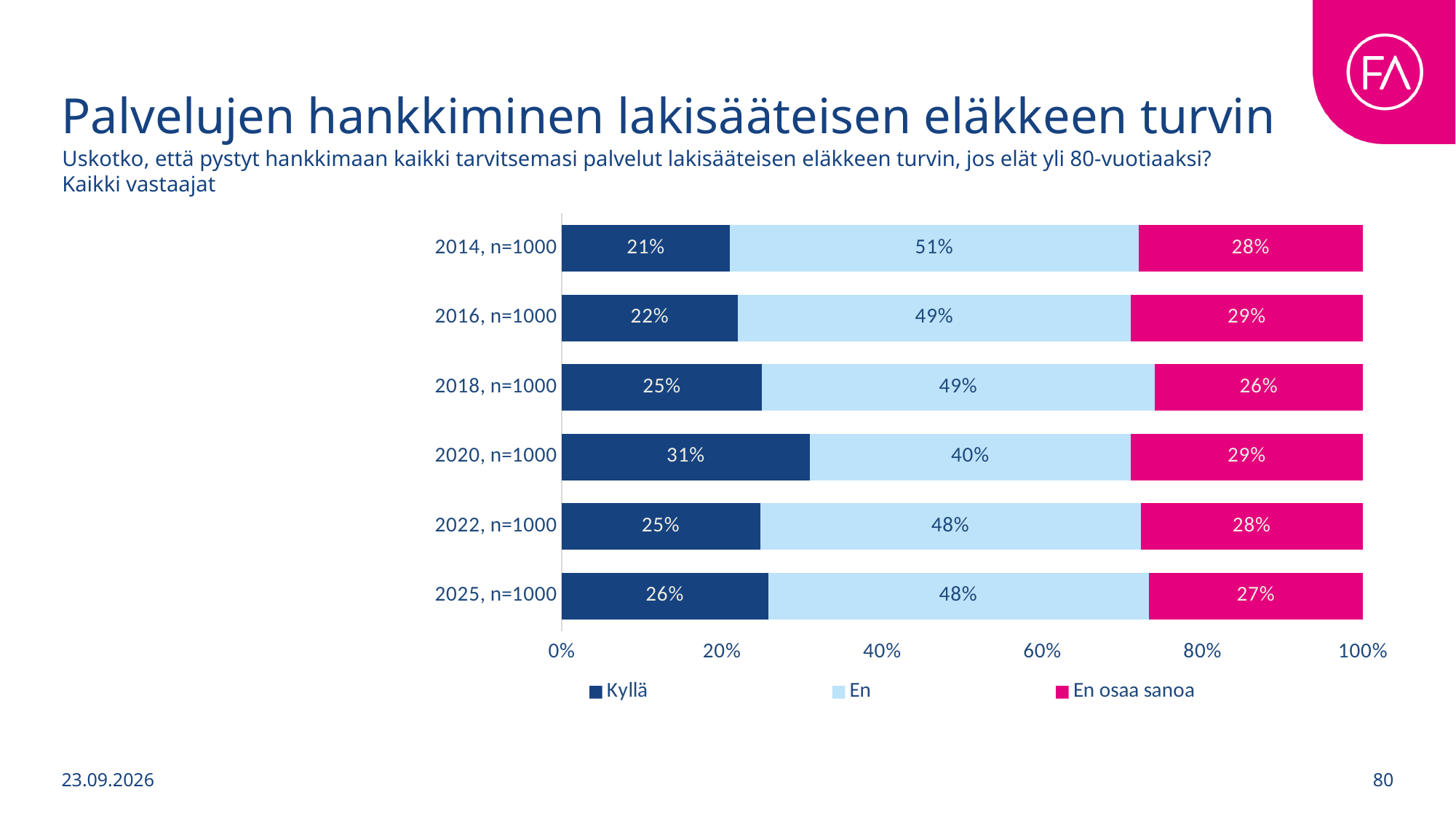
In which year was the "Kyllä" share the lowest? 2014, n=1000 What percentage of respondents answered "En osaa sanoa" in 2025, n=1000? 27% How many series does the legend list? 3 What kind of chart is shown on the slide? Stacked bar chart In which year was the "En" share the lowest? 2020, n=1000 What is the difference between the "Kyllä" share in 2020 and in 2014? 10 percentage points What percentage of respondents answered "En" in 2014, n=1000? 51% How many years (categories) are shown in the chart? 6 Which is larger: the "En" share in 2014 or the "En" share in 2022? 2014 What percentage of respondents answered "Kyllä" in 2020, n=1000? 31% In which year was the "Kyllä" share the highest? 2020, n=1000 Which series is shown in pink/magenta in the chart? En osaa sanoa